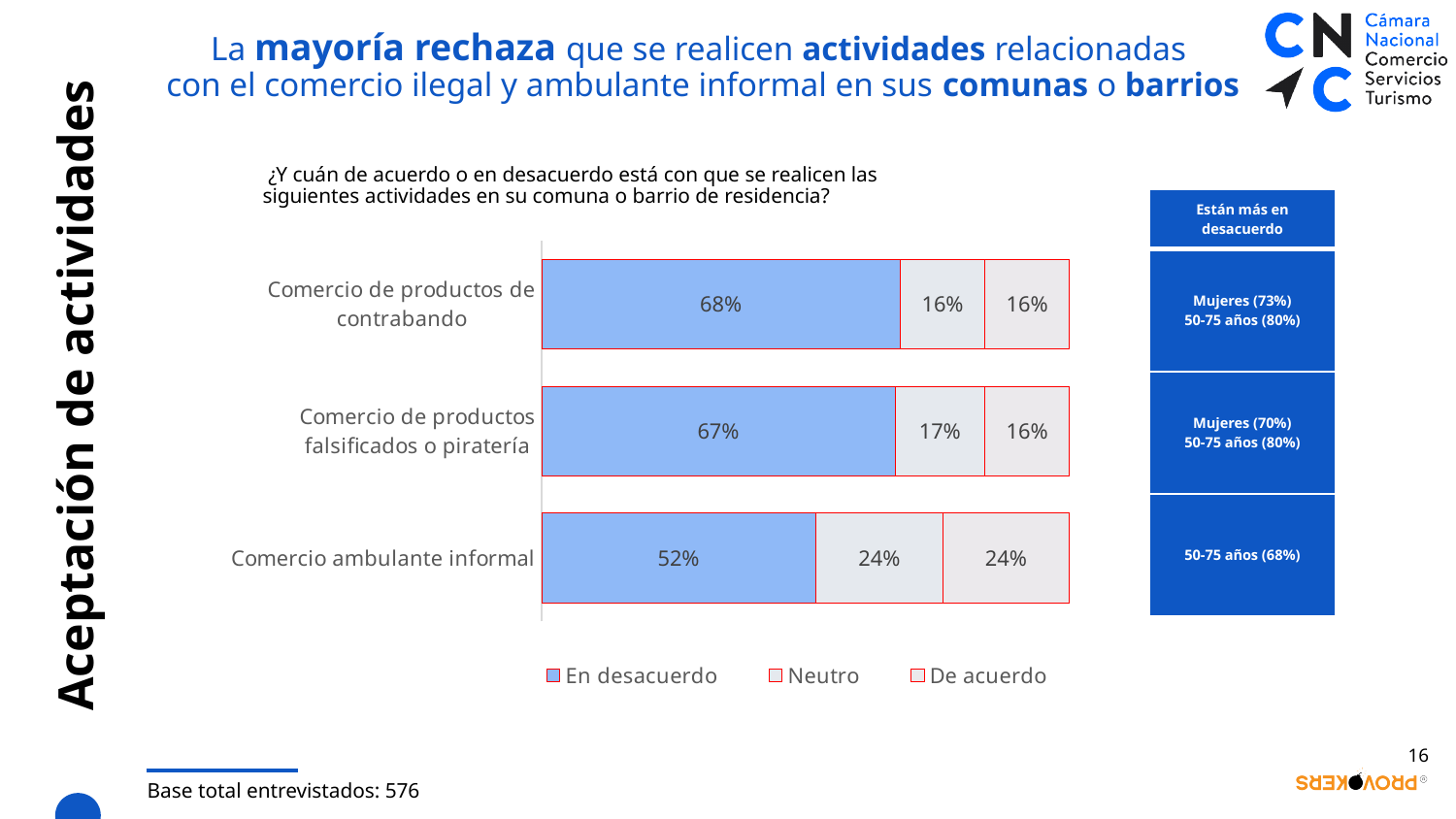
What is the total of the stacked bar for 'Comercio ambulante informal'? 100% Which category has the highest 'En desacuerdo' percentage? Comercio de productos de contrabando What is the difference between the 'En desacuerdo' values for 'Comercio de productos de contrabando' and 'Comercio ambulante informal'? 16% Which is larger: the 'Neutro' value for 'Comercio de productos falsificados o piratería' or for 'Comercio ambulante informal'? Comercio ambulante informal How many categories are shown in the chart? 3 How many series does the legend list? 3 What is the 'De acuerdo' value for 'Comercio de productos falsificados o piratería'? 16% What kind of chart is shown on the slide? Stacked bar chart What are the three legend entries of the chart? En desacuerdo, Neutro, De acuerdo What percentage of respondents are 'En desacuerdo' with 'Comercio de productos de contrabando'? 68% What is the 'Neutro' value for 'Comercio ambulante informal'? 24% Which category has the lowest 'En desacuerdo' percentage? Comercio ambulante informal